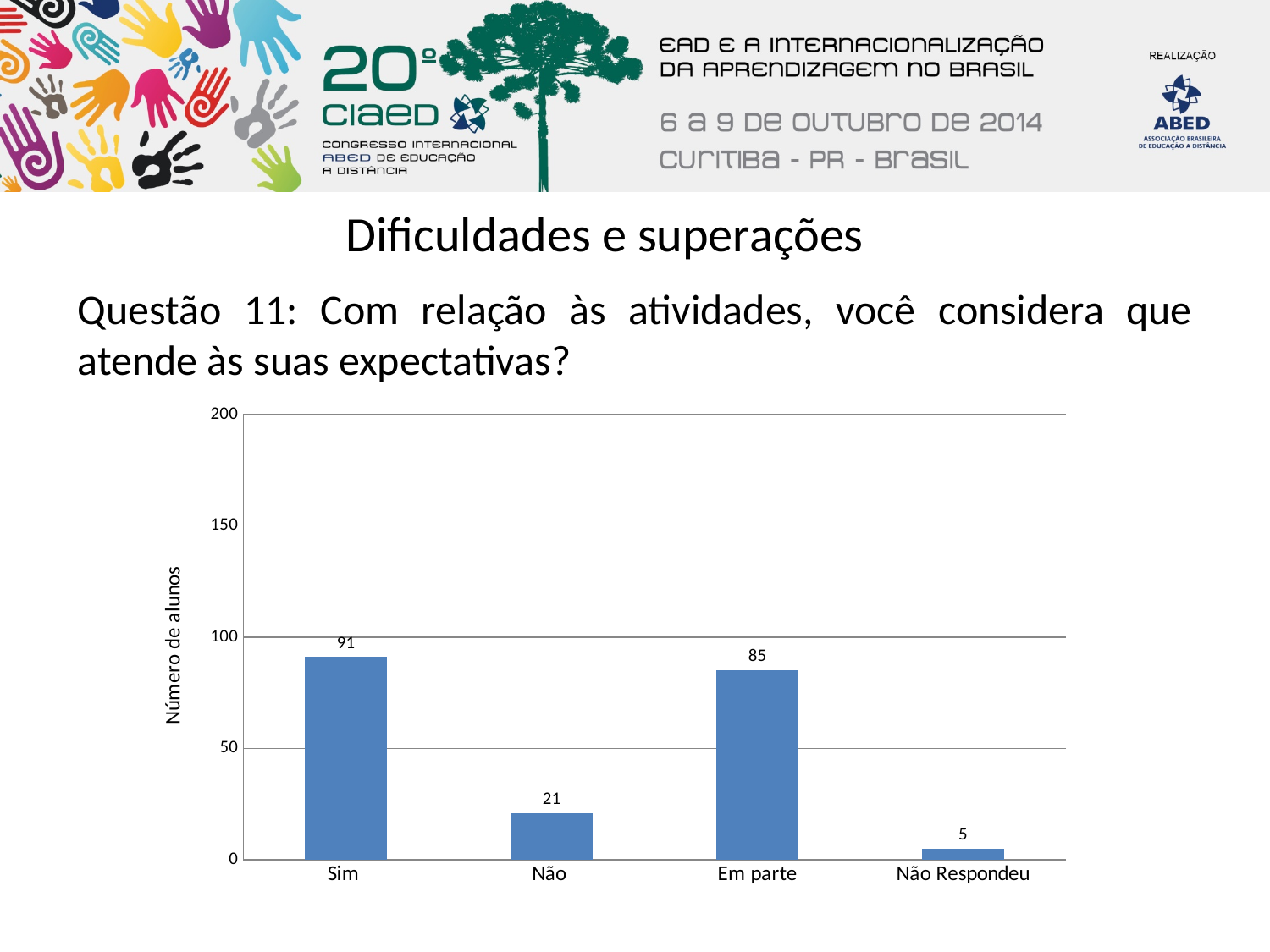
Which category has the highest number of students? Sim What is the value for Em parte? 85 What is the difference between the values for Não and Não Respondeu? 16 What is the value for Sim? 91 Which is larger, the value for Não or the value for Em parte? Em parte How many categories are shown on the x axis? 4 What kind of chart is shown on the slide? bar chart What is the value for Não Respondeu? 5 Which category has the lowest number of students? Não Respondeu Is the value for Sim greater or less than 100? less What is the value for Não? 21 What is the difference between the values for Sim and Em parte? 6